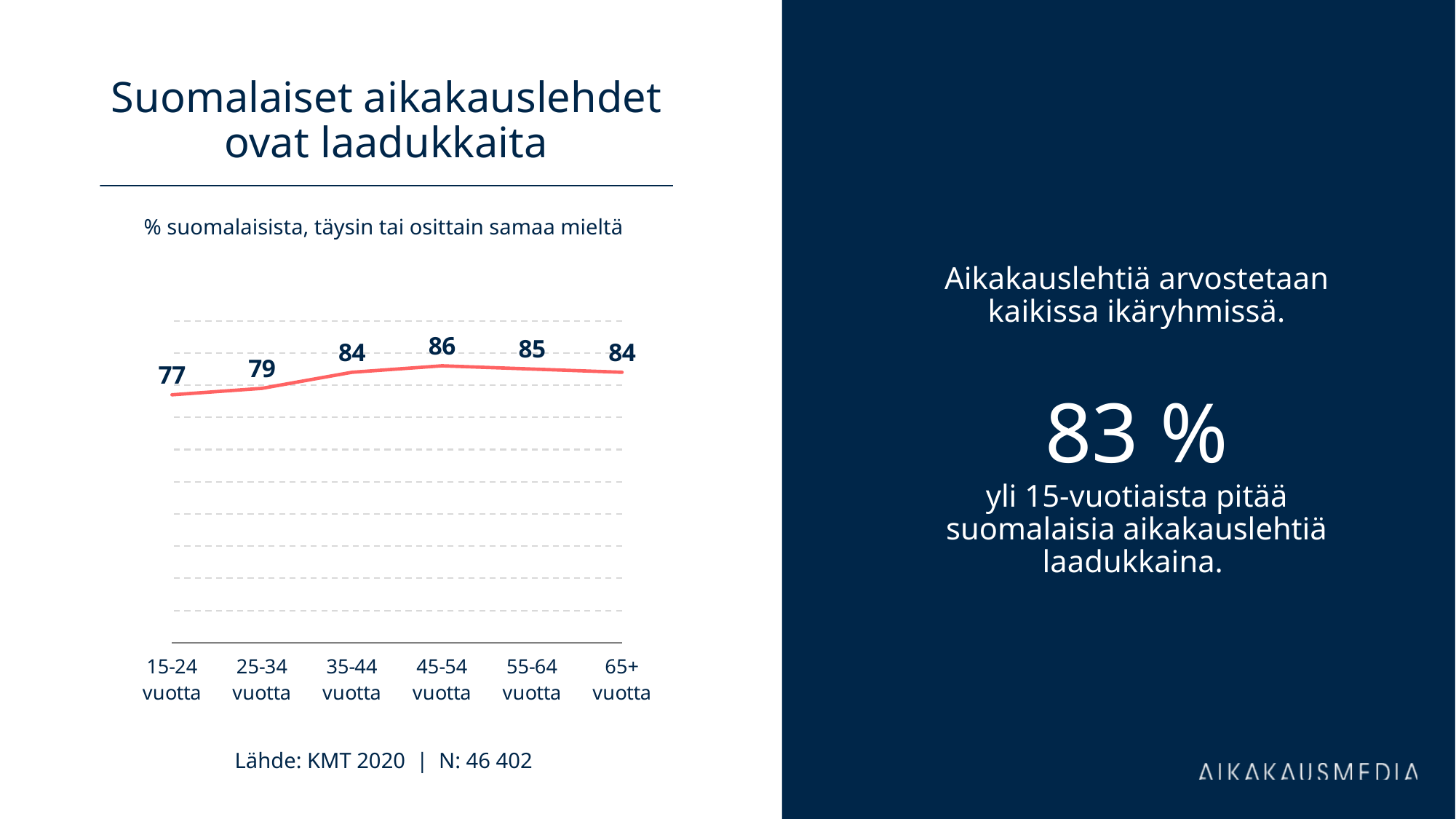
What is the value for the 45-54 vuotta age group? 86 Which is larger, the value for 25-34 vuotta or the value for 55-64 vuotta? 55-64 vuotta What is the difference between the values for 25-34 vuotta and 35-44 vuotta? 5 What kind of chart is shown on the slide? line chart What is the source cited below the chart? KMT 2020 How many age groups are plotted on the chart? 6 What is the value for the 65+ vuotta age group? 84 Which age group has the lowest value? 15-24 vuotta Which age group has the highest value? 45-54 vuotta What is the difference between the values for 45-54 vuotta and 15-24 vuotta? 9 What is the value for the 15-24 vuotta age group? 77 Do the values rise or fall from 15-24 vuotta to 45-54 vuotta? rise